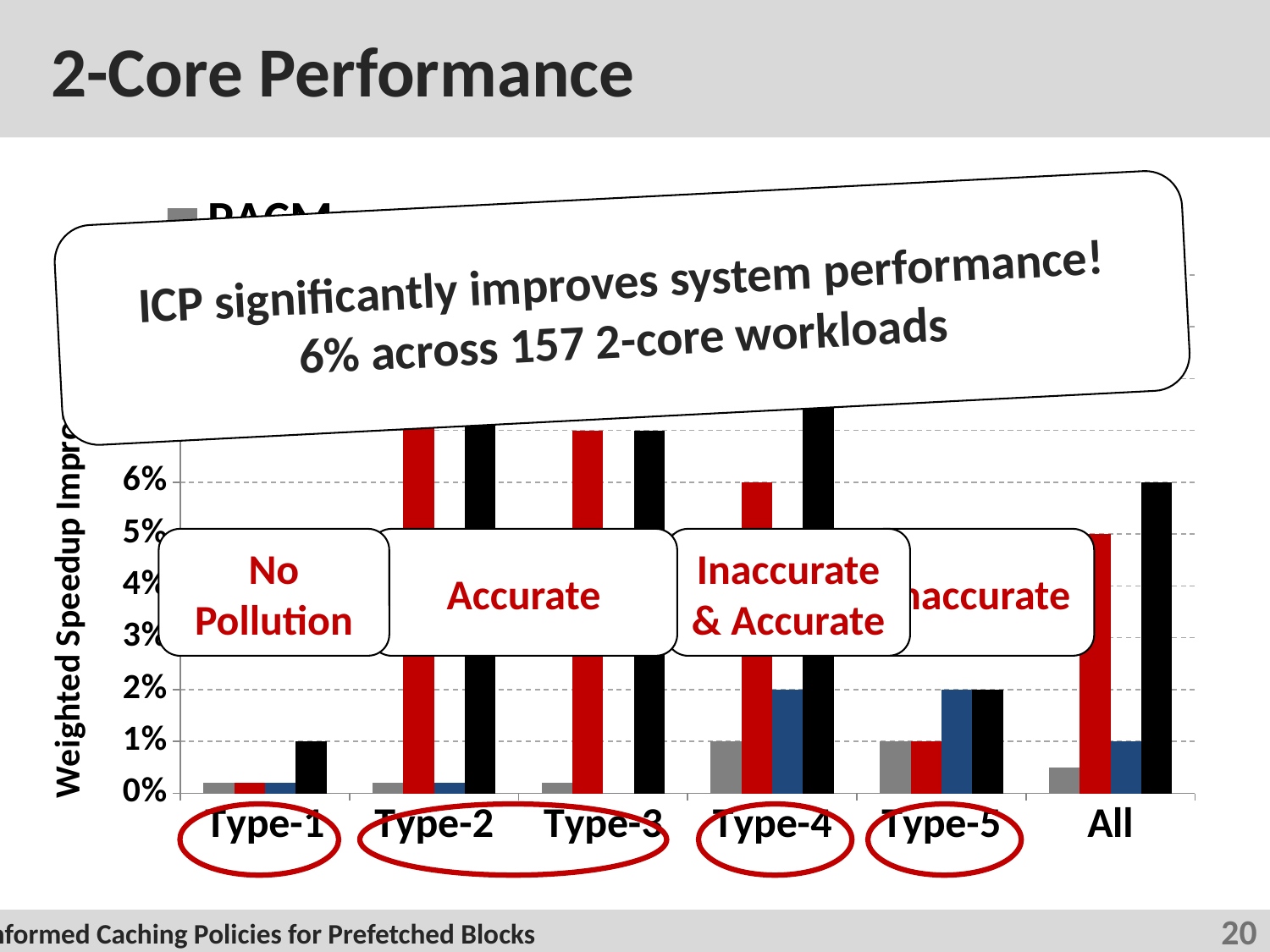
Among the categories, which has the lowest black bar? Type-1 For the All category, which is larger: the red bar or the black bar? the black bar What is the value of the black bar for the All category? 6% How many categories are shown along the x axis of the chart? 6 What is the value of the blue bar for Type-4? 2% What is the value of the black bar for Type-1? 1% What is the title of the slide containing the chart? 2-Core Performance What kind of chart is shown on the slide? bar chart Is the value of the red bar for Type-1 greater or less than 1%? less Is the value of the red bar for Type-5 greater or less than 3%? less Is the value of the black bar for Type-4 greater or less than 5%? greater Which annotation label is placed above the Type-1 category on the chart? No Pollution